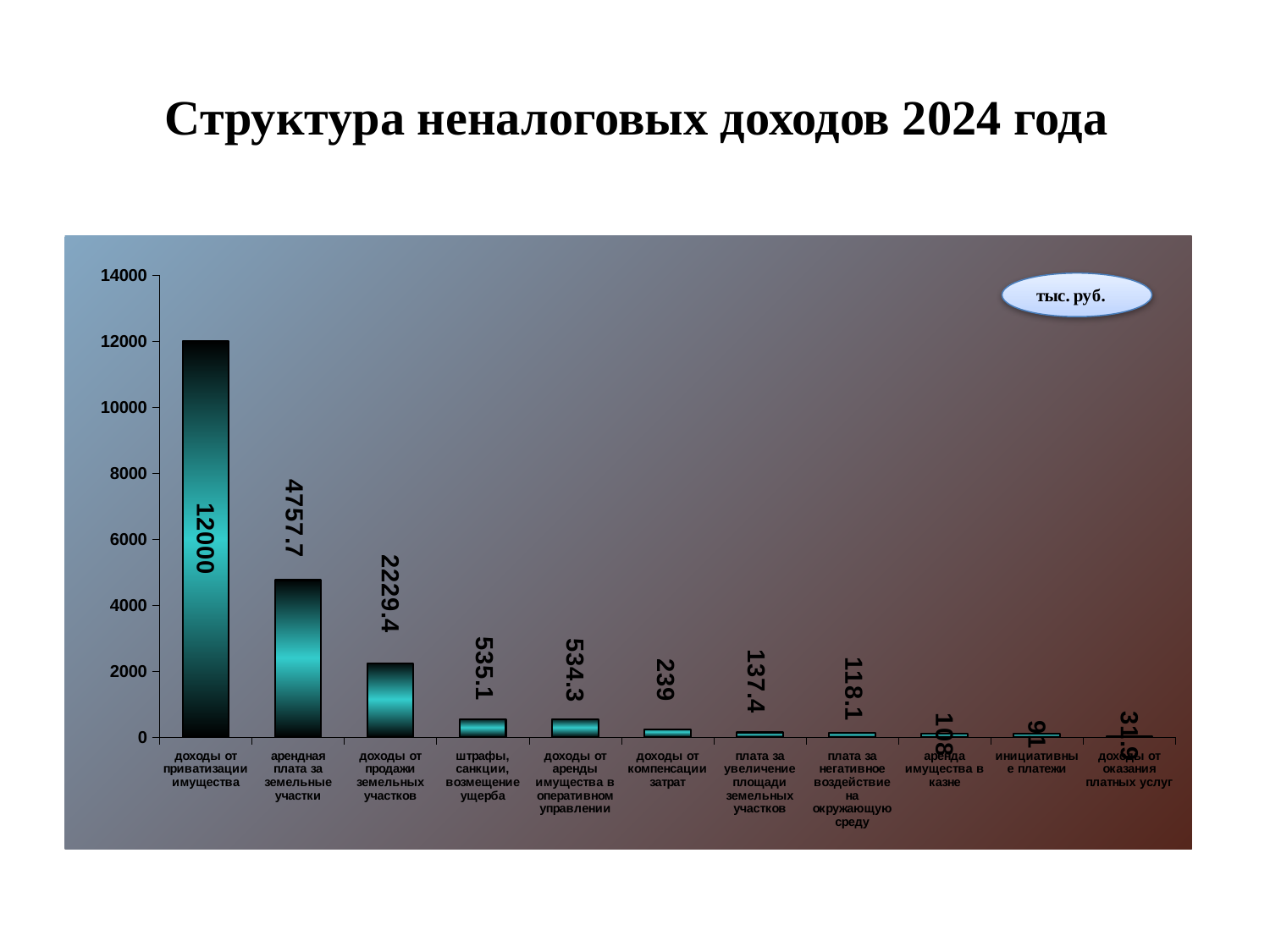
How many categories are shown in the chart? 11 What unit of measurement is indicated on the chart? тыс. руб. What is the value for штрафы, санкции, возмещение ущерба? 535.1 What is the value for доходы от приватизации имущества? 12000 Which category has the lowest value? доходы от оказания платных услуг Which category has the highest value? доходы от приватизации имущества What is the difference between the values for доходы от приватизации имущества and арендная плата за земельные участки? 7242.3 What is the value for плата за негативное воздействие на окружающую среду? 118.1 Which is larger: доходы от продажи земельных участков or доходы от компенсации затрат? доходы от продажи земельных участков Is the value for арендная плата за земельные участки greater or less than 4000? greater What kind of chart is shown on the slide? bar chart What is the value for арендная плата за земельные участки? 4757.7